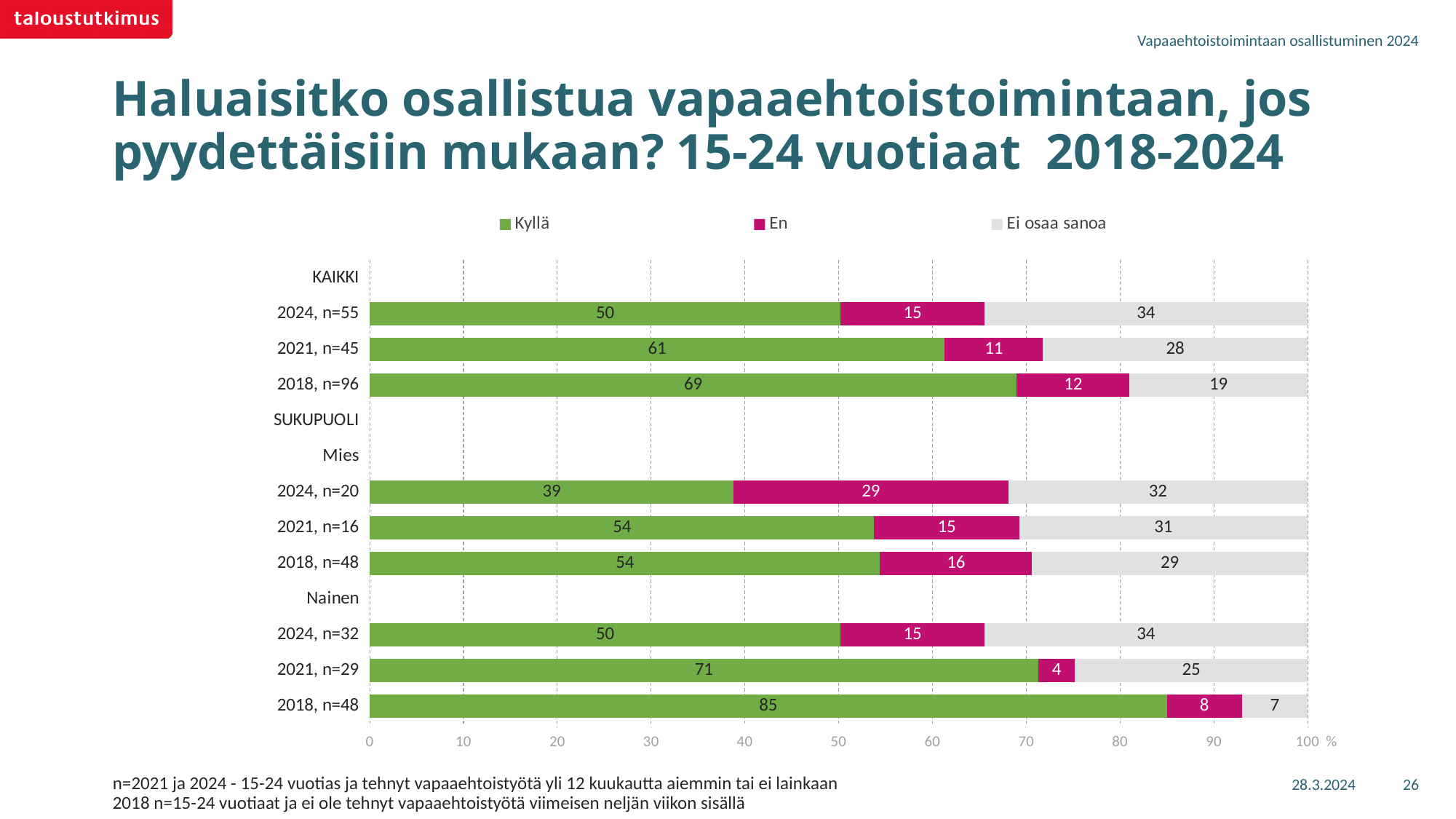
What is the Ei osaa sanoa value for Nainen 2018, n=48? 7 Does the Kyllä value for KAIKKI decrease or increase from 2018 to 2024? Decrease Which bar has the highest Kyllä value? Nainen 2018, n=48 Which is larger, the En value for Mies 2021, n=16 or the En value for Nainen 2021, n=29? Mies 2021, n=16 How many series does the legend list? 3 Which bar has the lowest Kyllä value? Mies 2024, n=20 What is the difference between the Kyllä values for KAIKKI 2018, n=96 and KAIKKI 2024, n=55? 19 How many bars with data are plotted in the chart? 9 What is the Kyllä value for KAIKKI 2024, n=55? 50 What are the three legend entries? Kyllä, En, Ei osaa sanoa What is the En value for Mies 2024, n=20? 29 What kind of chart is shown on the slide? Stacked bar chart